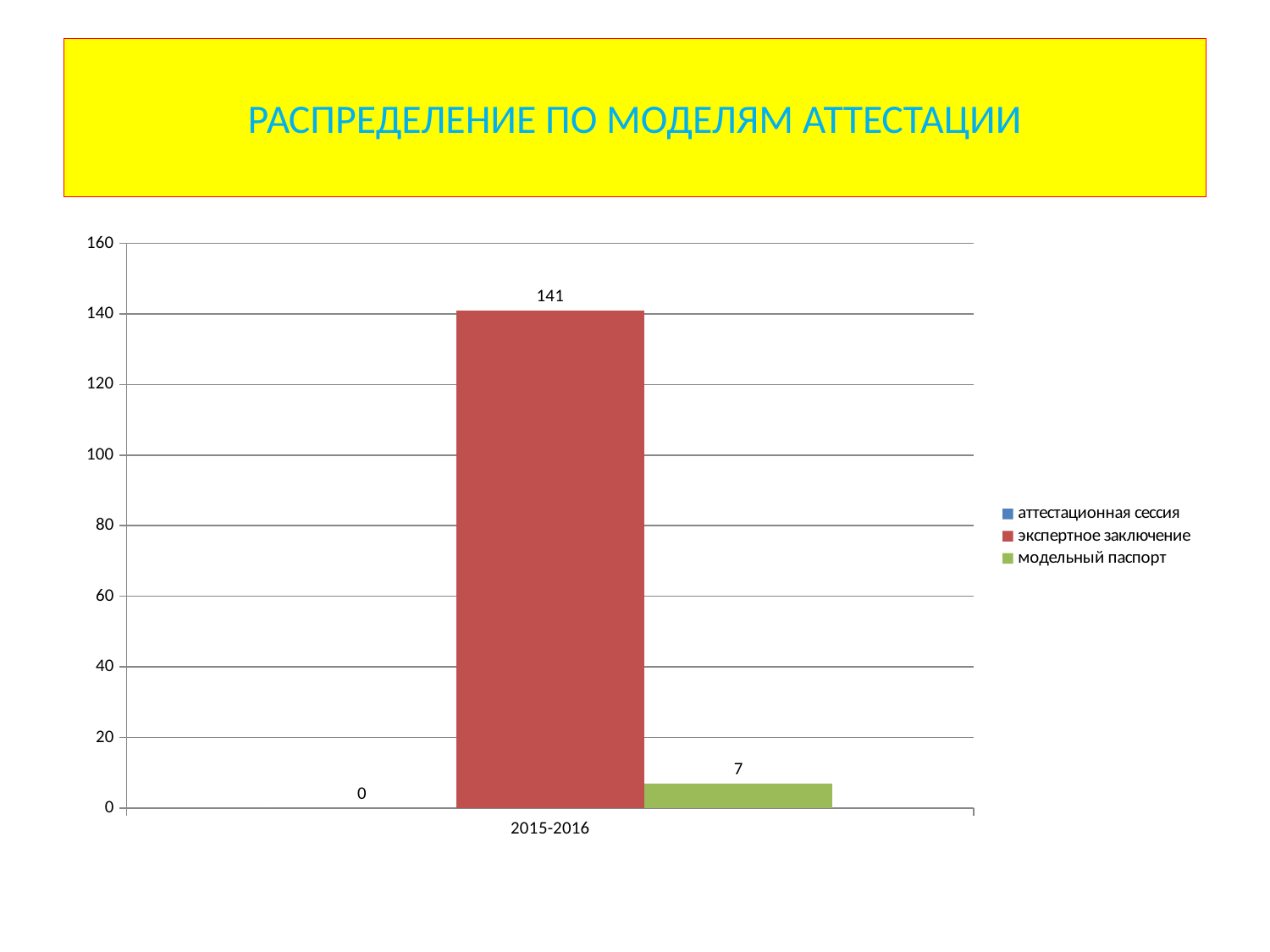
Which series has the highest value in 2015-2016? экспертное заключение What is the title of the slide? РАСПРЕДЕЛЕНИЕ ПО МОДЕЛЯМ АТТЕСТАЦИИ What is the value for модельный паспорт in 2015-2016? 7 Is the value for экспертное заключение greater or less than 140? greater Which is larger, the value for модельный паспорт or the value for аттестационная сессия? модельный паспорт What is the difference between the values for экспертное заключение and модельный паспорт? 134 How many series does the legend list? 3 Which series has the lowest value in 2015-2016? аттестационная сессия What kind of chart is shown on the slide? bar chart How many categories are shown on the x axis? 1 What is the value for экспертное заключение in 2015-2016? 141 What is the value for аттестационная сессия in 2015-2016? 0